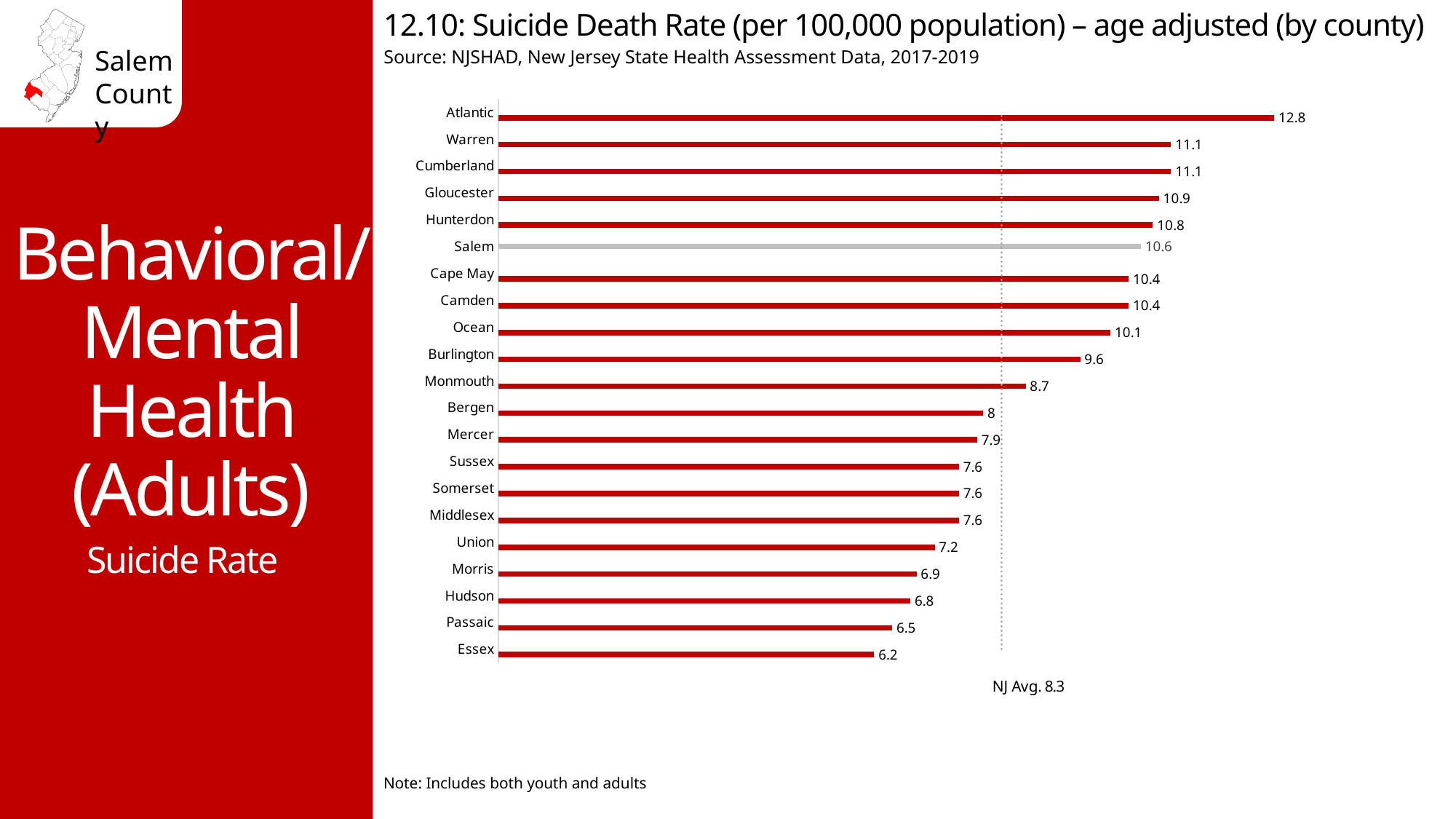
What is the suicide death rate for Atlantic County? 12.8 How many counties are shown in the chart? 21 What kind of chart is shown on the slide? Bar chart What is the suicide death rate for Salem County? 10.6 What is the NJ average suicide death rate shown on the chart? 8.3 Which county's bar is shown in grey instead of red? Salem What is the difference between the suicide death rates of Atlantic and Salem? 2.2 Which county has the highest suicide death rate? Atlantic What is the difference between the suicide death rate for Salem and the NJ average? 2.3 Which has a higher suicide death rate, Gloucester or Cape May? Gloucester What is the suicide death rate for Essex County? 6.2 Which county has the lowest suicide death rate? Essex